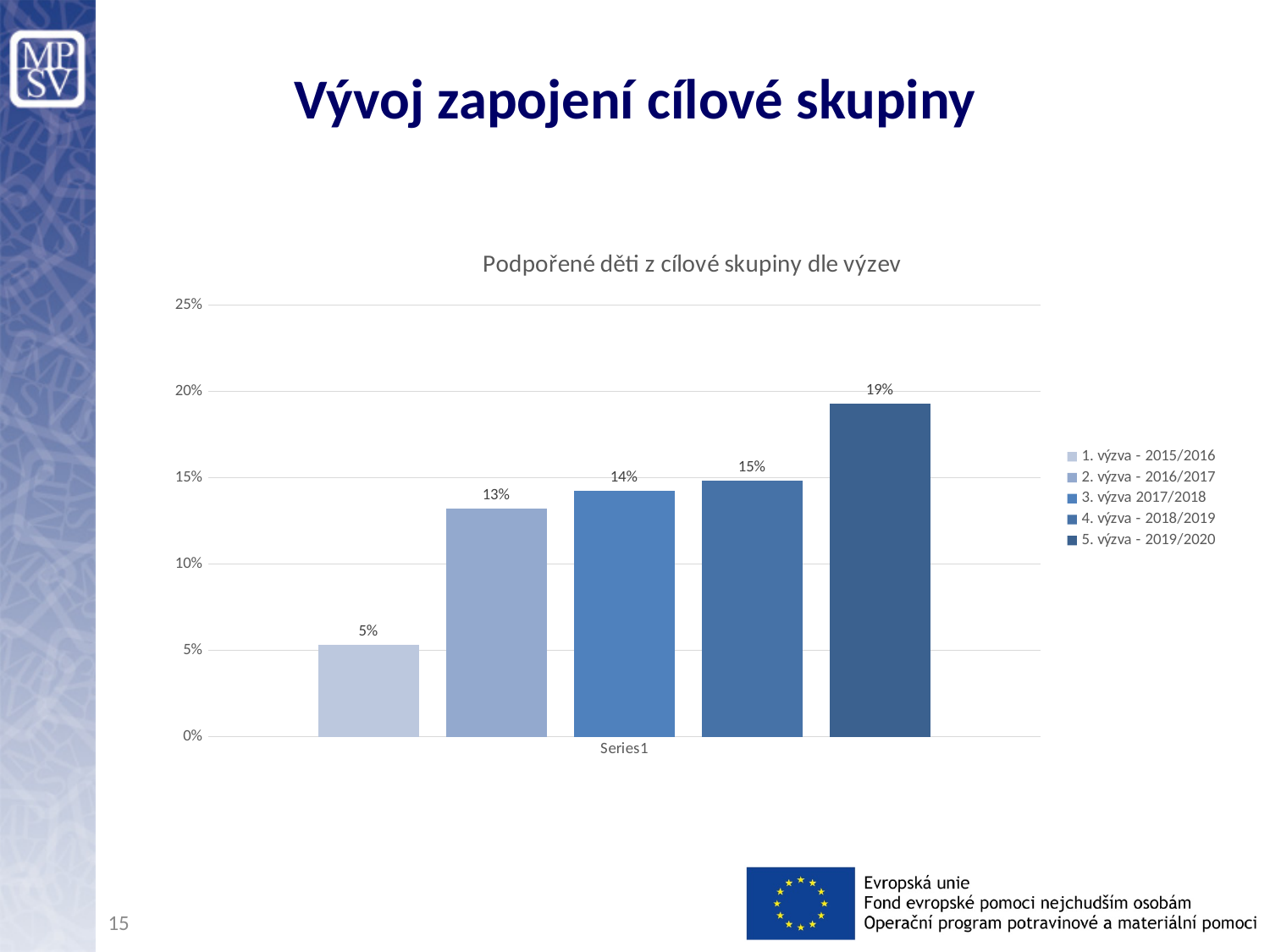
What is the value for 1. výzva - 2015/2016? 5% Do the values rise or fall from 1. výzva to 5. výzva? rise What kind of chart is shown? bar chart What is the value for 5. výzva - 2019/2020? 19% What is the difference between the values for 5. výzva - 2019/2020 and 1. výzva - 2015/2016? 14% What is the title of the chart? Podpořené děti z cílové skupiny dle výzev Which series has the highest value? 5. výzva - 2019/2020 How many series does the legend list? 5 Which is larger, the value for 2. výzva - 2016/2017 or 4. výzva - 2018/2019? 4. výzva - 2018/2019 Is the value for 4. výzva - 2018/2019 greater or less than 10%? greater What is the value for 3. výzva 2017/2018? 14% Which series has the lowest value? 1. výzva - 2015/2016